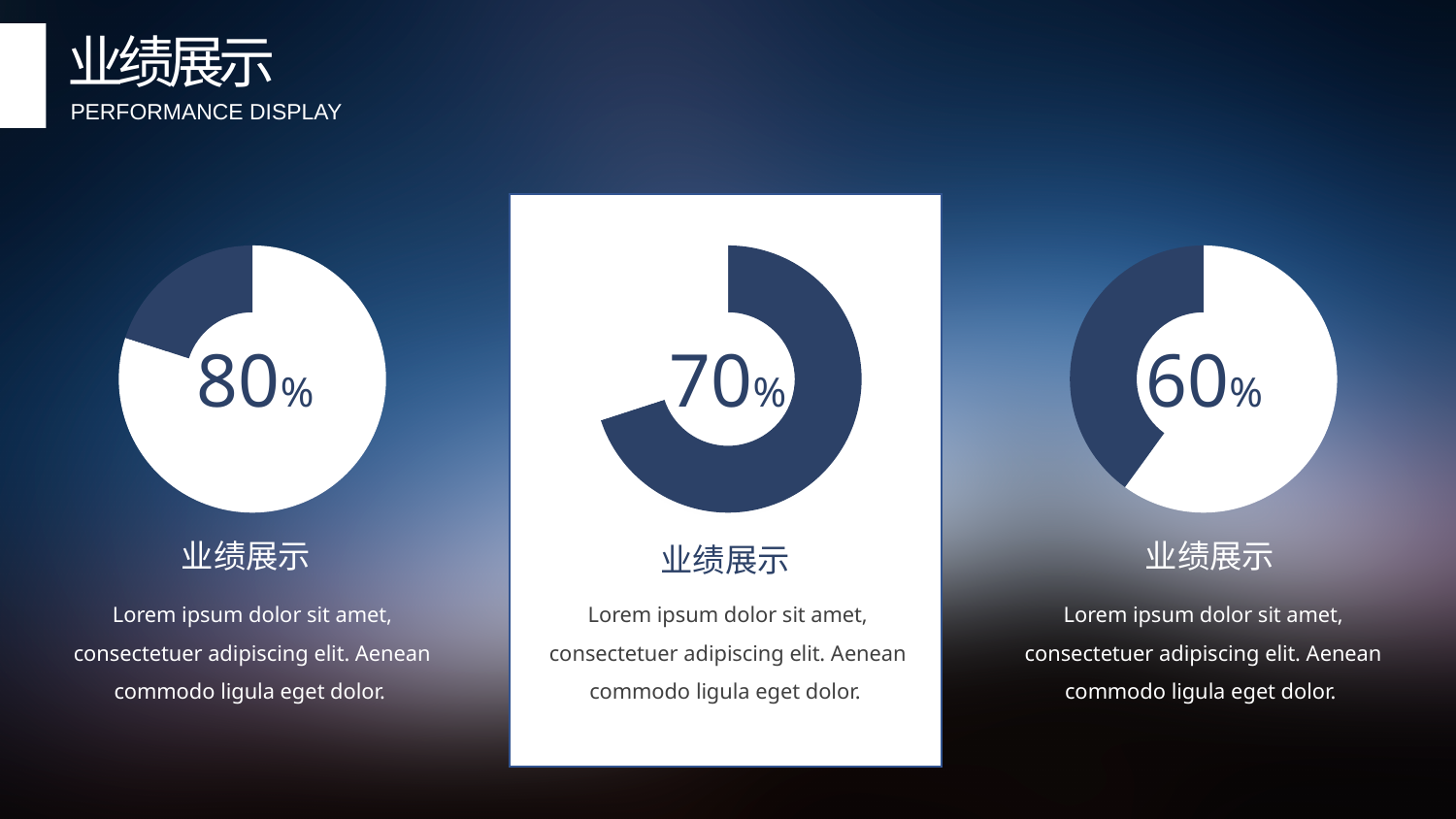
Which is larger, the percentage in the left chart or the percentage in the middle chart? The left chart (80%) What percentage is shown in the centre of the middle chart? 70% What is the English subtitle of the slide? PERFORMANCE DISPLAY Which of the three charts shows the highest percentage? The left chart (80%) What is the difference between the percentage in the middle chart and the percentage in the right chart? 10% What is the title printed below the middle chart? 业绩展示 What kind of chart is the middle chart? Donut (pie) chart What is the difference between the percentage in the left chart and the percentage in the right chart? 20% What percentage is shown in the centre of the right chart? 60% Which of the three charts shows the lowest percentage? The right chart (60%) What percentage is shown in the centre of the left chart? 80% How many charts are shown on the slide? 3